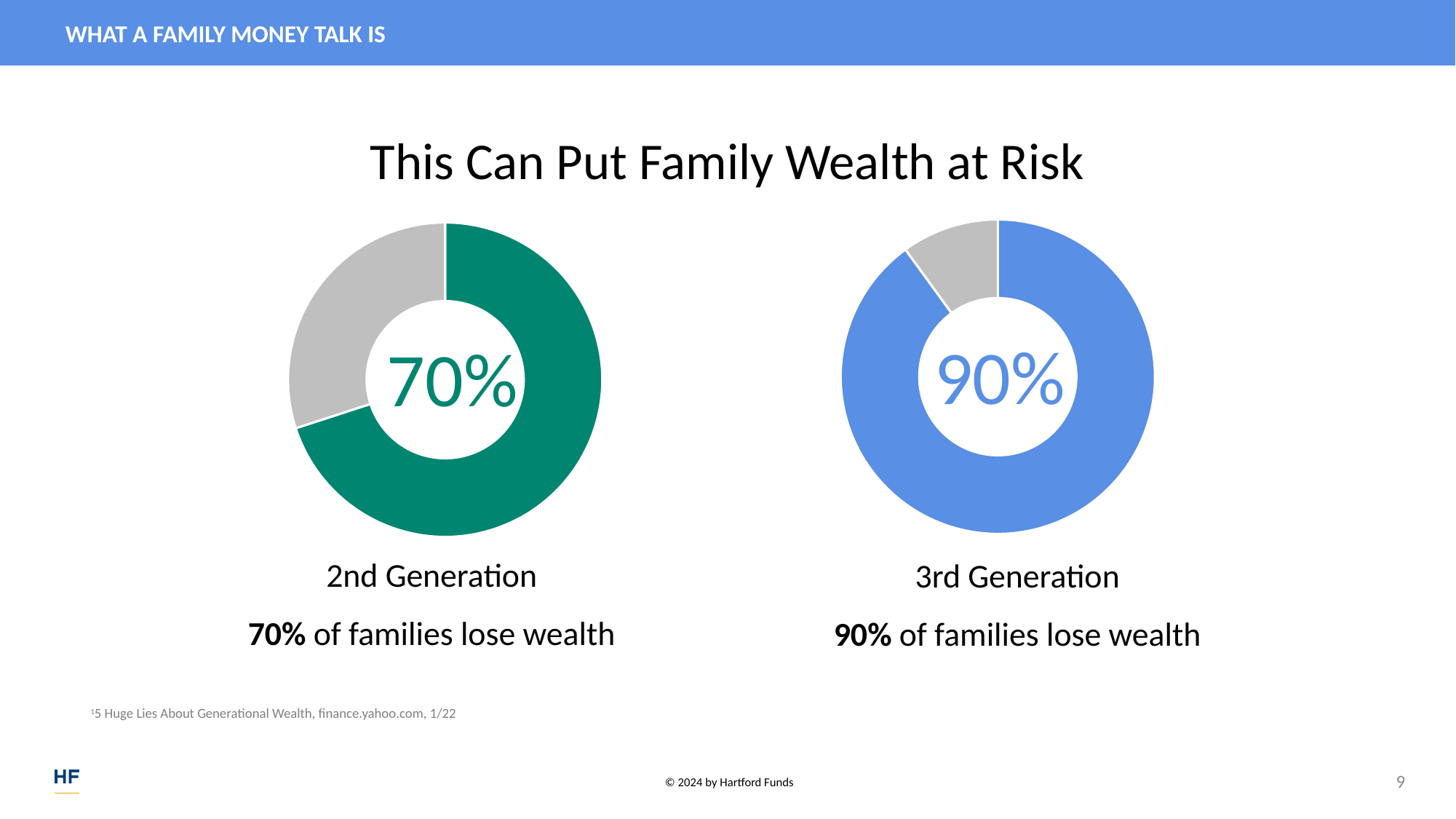
What colour is the main segment of the 3rd Generation donut chart? Blue What kind of chart is used for the 2nd Generation figure? Donut chart What is the difference in percentage points between the 3rd Generation value and the 2nd Generation value? 20 How many donut charts are shown on the slide? 2 What is the title above the two donut charts? This Can Put Family Wealth at Risk In the 2nd Generation chart, what share of the donut is coloured green? 70% Which generation's chart shows the higher percentage of families losing wealth, 2nd Generation or 3rd Generation? 3rd Generation What percentage is shown in the centre of the 2nd Generation donut chart? 70% In the 3rd Generation chart, what share of the donut is coloured grey? 10% What percentage is shown in the centre of the 3rd Generation donut chart? 90% Which chart has the smaller grey segment, 2nd Generation or 3rd Generation? 3rd Generation In the 2nd Generation chart, what share of the donut is coloured grey? 30%